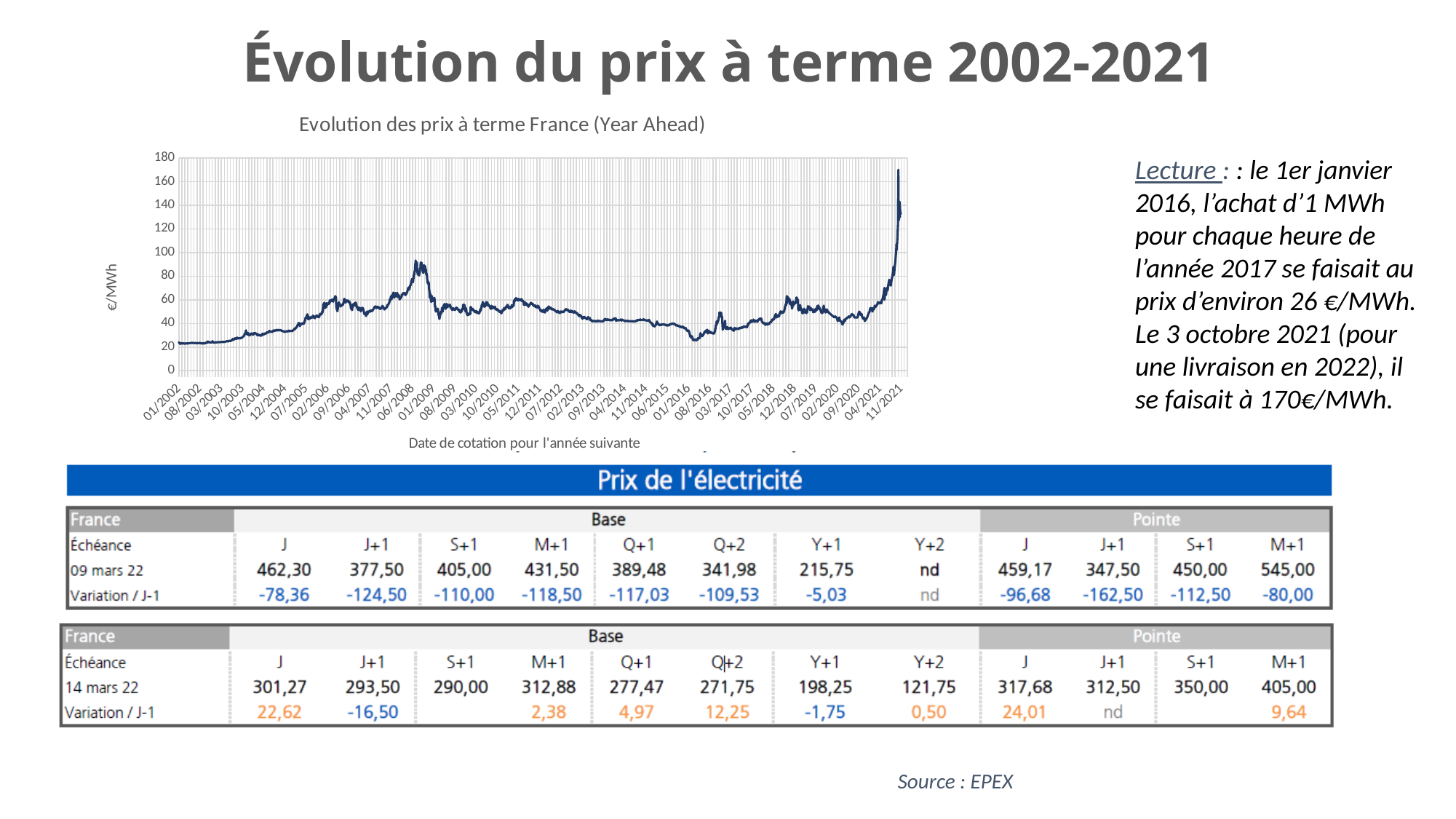
In which year does the line reach its highest value? 2021 What unit is shown on the vertical axis of the chart? €/MWh Does the line rise or fall between 01/2002 and the 2008 peak? rise Which is larger: the value at 11/2021 or the peak value in 2008? 11/2021 How many data series are plotted on the chart? 1 Is the value at the start of the series (01/2002) greater or less than 40? less Is the peak value reached in 2008 greater or less than 80? greater What kind of chart is shown on the slide? line chart Is the value around 01/2016 greater or less than 40? less What is the highest tick value shown on the vertical axis? 180 What is the title of the chart? Evolution des prix à terme France (Year Ahead)